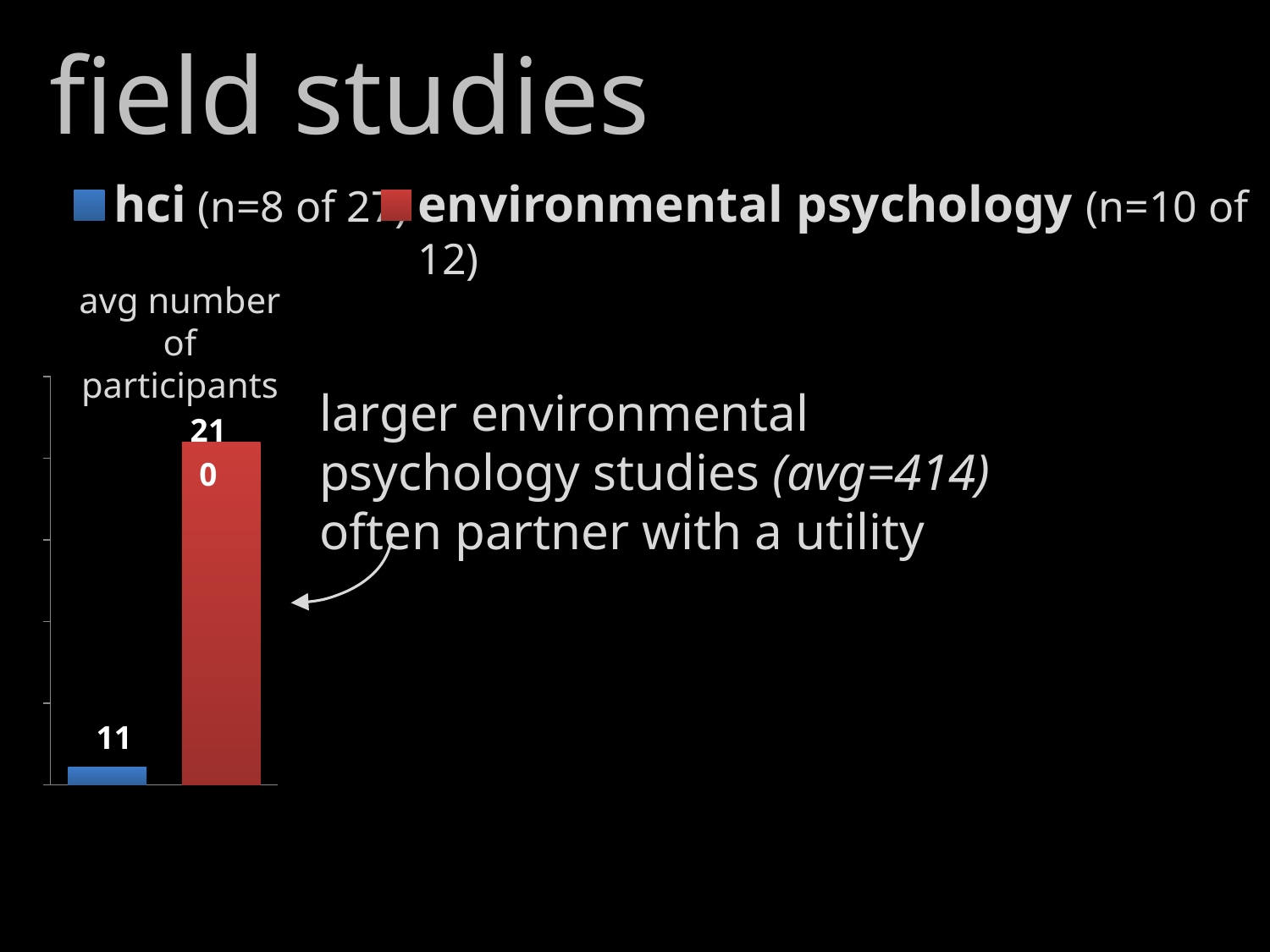
Is the average number of participants larger for hci or for environmental psychology? environmental psychology Which field has the lower average number of participants? hci What colour is the bar for hci? blue How many series does the legend list? 2 Which field has the higher average number of participants? environmental psychology What is the average number of participants for hci? 11 What does the chart's axis title say is being measured? avg number of participants What is the average number of participants for environmental psychology? 210 How many bars are plotted in the chart? 2 What kind of chart is shown on the slide? bar chart